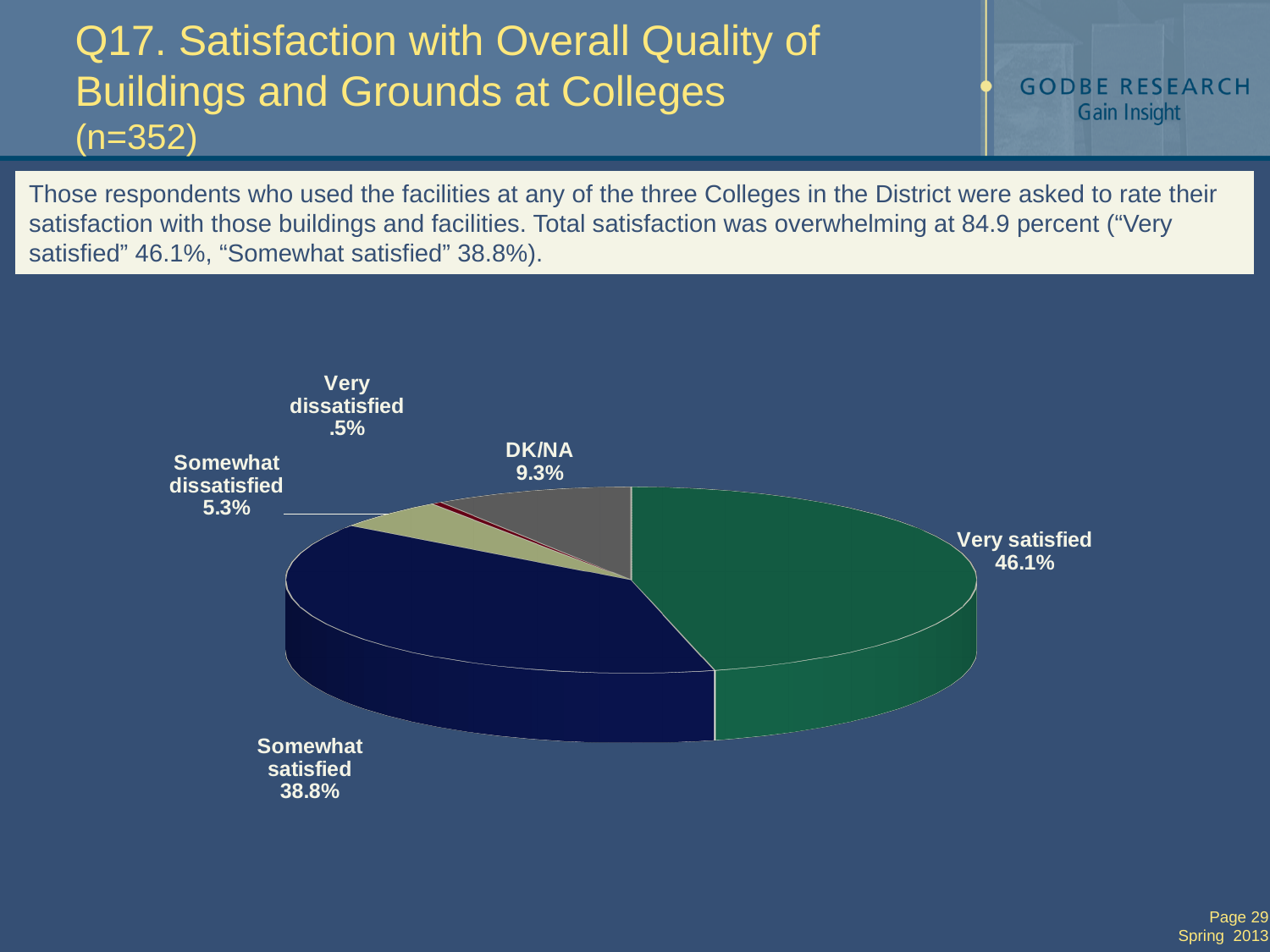
What percentage of respondents were "Somewhat dissatisfied"? 5.3% What kind of chart is shown on the slide? Pie chart Which is larger, the share for DK/NA or the share for "Somewhat dissatisfied"? DK/NA What percentage of respondents were "Somewhat satisfied"? 38.8% How many categories are shown in the pie chart? 5 Which category has the largest share of the pie? Very satisfied What is the difference in percentage points between "Very satisfied" and "Somewhat satisfied"? 7.3 What is the combined share of "Very satisfied" and "Somewhat satisfied"? 84.9% What percentage of respondents were "Very satisfied"? 46.1% What percentage of respondents answered DK/NA? 9.3% Which category has the smallest share of the pie? Very dissatisfied What percentage of respondents were "Very dissatisfied"? .5%